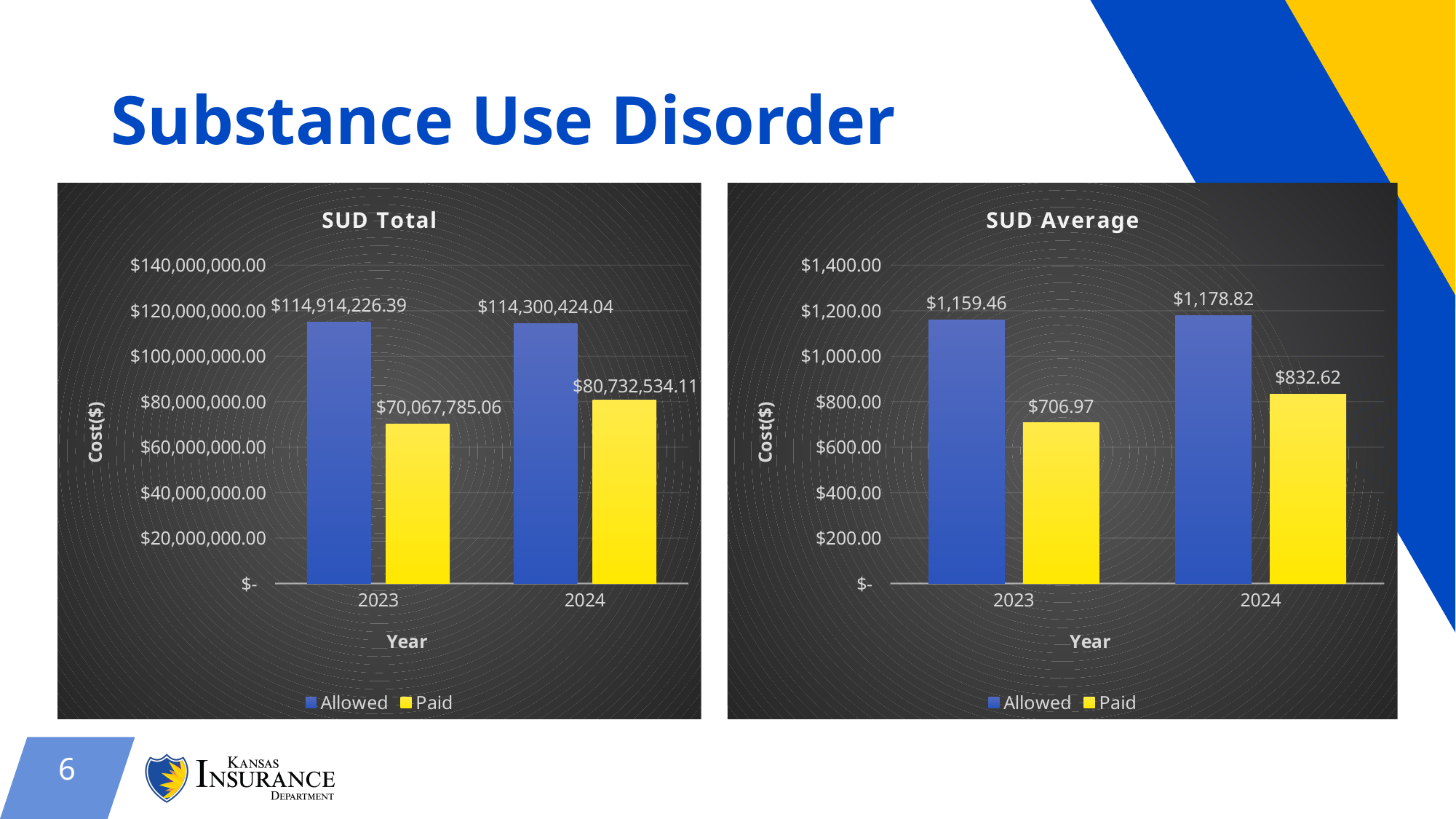
In the SUD Average chart, what is the Paid value for 2023? $706.97 In the SUD Average chart, which is larger: the Paid value for 2023 or the Paid value for 2024? 2024 In the SUD Total chart, what is the difference between the Allowed values for 2023 and 2024? $613,802.35 In the SUD Average chart, does the Paid value rise or fall from 2023 to 2024? rise In the SUD Total chart, is the Paid value for 2023 greater or less than $80,000,000.00? less In the SUD Average chart, what is the Allowed value for 2024? $1,178.82 In the SUD Total chart, what is the Paid value for 2024? $80,732,534.11 What kind of chart is the SUD Total chart? bar chart In the SUD Average chart, what is the difference between the Allowed values for 2024 and 2023? $19.36 How many series does the legend of the SUD Average chart list? 2 In the SUD Total chart, what is the difference between the Paid values for 2024 and 2023? $10,664,749.05 In the SUD Total chart, what is the Allowed value for 2023? $114,914,226.39